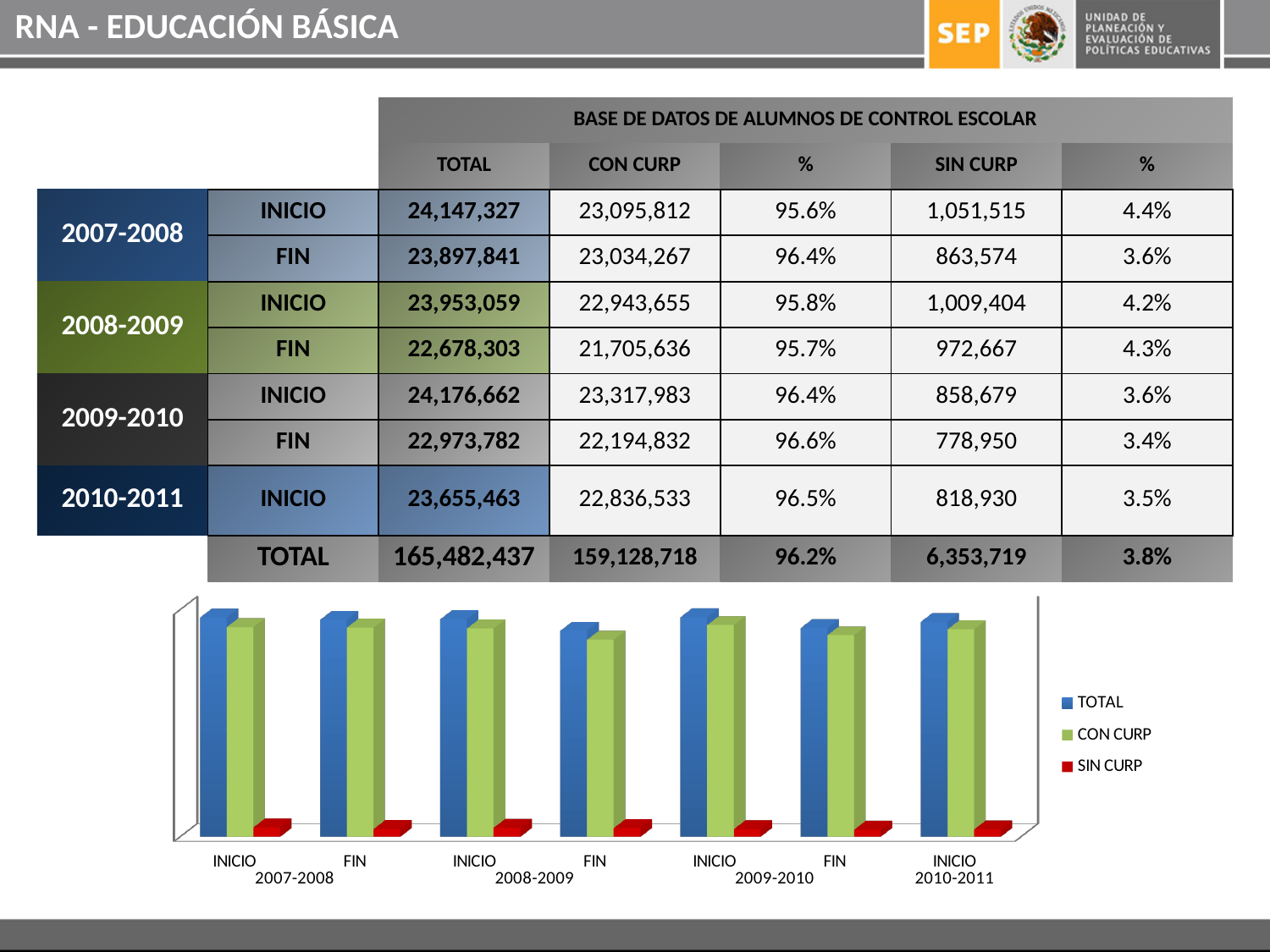
How many series does the chart's legend list? 3 In the chart, is the TOTAL bar for 2008-2009 FIN taller or shorter than the TOTAL bar for 2008-2009 INICIO? shorter How many groups of bars (categories) are plotted along the x axis of the chart? 7 What kind of chart is shown at the bottom of the slide? bar chart What are the three series named in the chart's legend? TOTAL, CON CURP, SIN CURP In the chart, which series has the shortest bars in every category? SIN CURP What is the TOTAL value plotted for 2010-2011 INICIO, as printed in the table above the chart? 23,655,463 What is the SIN CURP value plotted for 2007-2008 INICIO, as printed in the table above the chart? 1,051,515 Which series is drawn in red in the chart? SIN CURP In the chart, is the CON CURP bar for 2009-2010 INICIO taller or shorter than the CON CURP bar for 2009-2010 FIN? taller Which category has the lowest TOTAL bar in the chart? 2008-2009 FIN Within each school year shown in the chart, do the TOTAL bars rise or fall from INICIO to FIN? fall